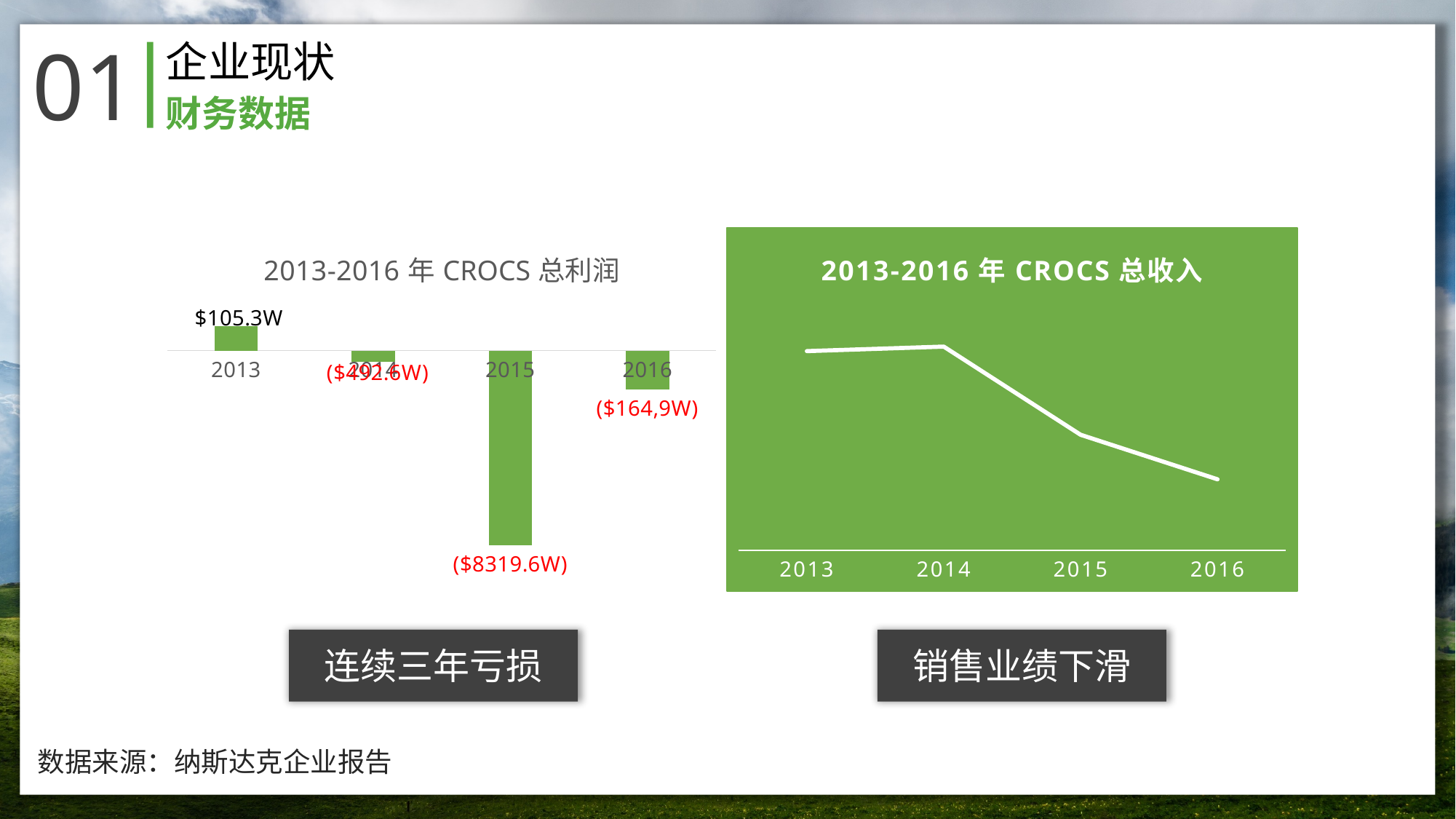
What kind of chart is the one titled 2013-2016 年 CROCS 总收入? line chart In the chart titled 2013-2016 年 CROCS 总利润, which year has the lowest value? 2015 In the chart titled 2013-2016 年 CROCS 总利润, what is the value for 2014? ($492.6W) In the chart titled 2013-2016 年 CROCS 总利润, which year has the larger value, 2014 or 2016? 2014 In the chart titled 2013-2016 年 CROCS 总利润, what is the value for 2015? ($8319.6W) In the chart titled 2013-2016 年 CROCS 总利润, what is the value for 2013? $105.3W In the chart titled 2013-2016 年 CROCS 总利润, what is the value for 2016? ($164,9W) In the chart titled 2013-2016 年 CROCS 总利润, which year has the highest value? 2013 What is the title of the chart on the right side of the slide? 2013-2016 年 CROCS 总收入 In the chart titled 2013-2016 年 CROCS 总利润, how many years are shown? 4 In the chart titled 2013-2016 年 CROCS 总收入, do the values rise or fall from 2014 to 2016? fall What kind of chart is the one titled 2013-2016 年 CROCS 总利润? bar chart